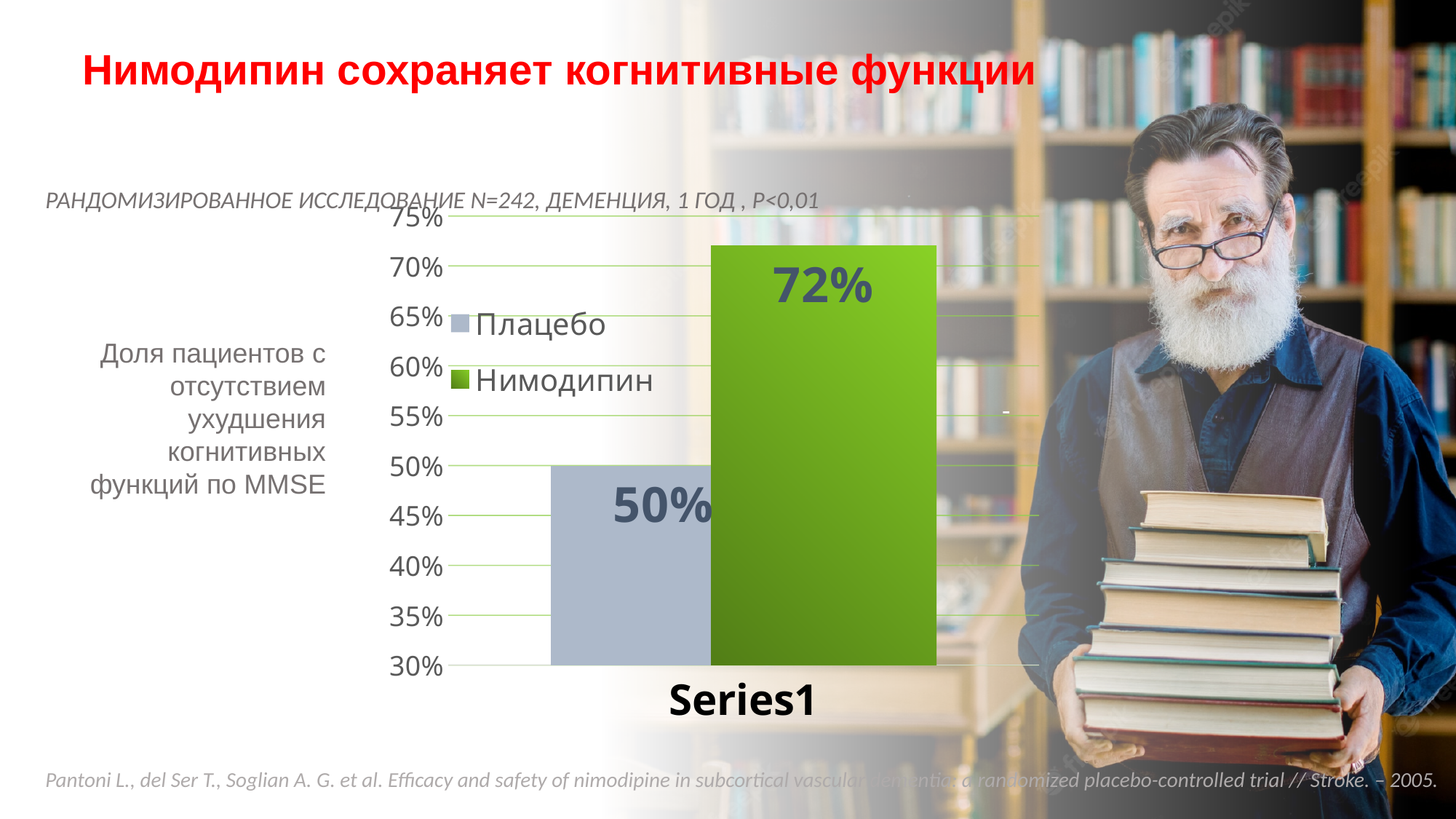
What is the difference between the Нимодипин and Плацебо values? 22% Which series has the lowest value? Плацебо How many series does the legend list? 2 What is the value for Плацебо? 50% What is the value for Нимодипин? 72% What colour is the bar for Нимодипин? green Which series has the higher value, Плацебо or Нимодипин? Нимодипин How many bars are plotted in the chart? 2 What kind of chart is shown on the slide? bar chart Is the value for Нимодипин greater or less than 70%? greater What is the label shown on the category axis below the bars? Series1 Is the value for Плацебо greater or less than 55%? less